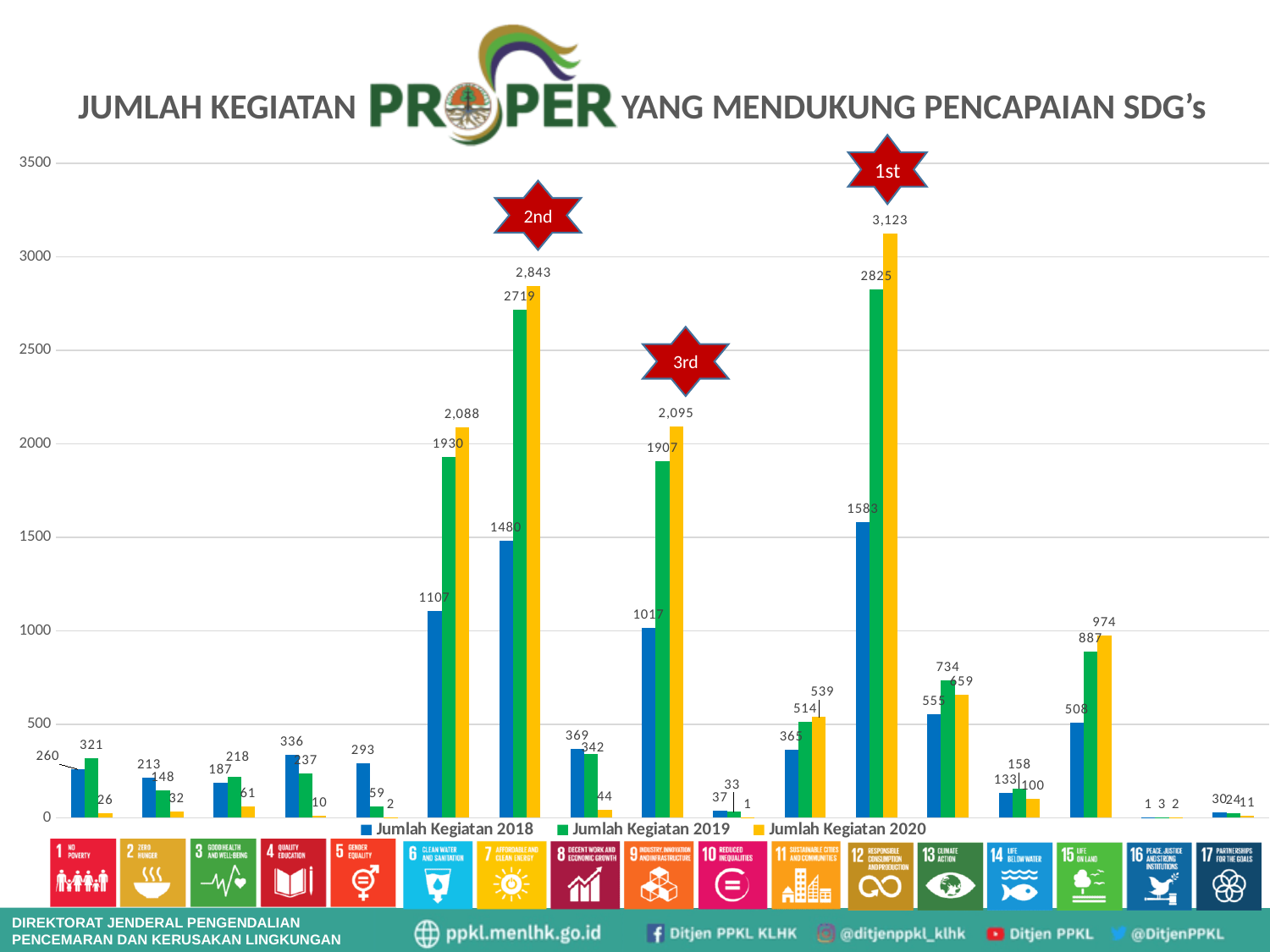
Which SDG has the lowest Jumlah Kegiatan 2018 value? SDG 16 (Peace, Justice and Strong Institutions) What kind of chart is shown on the slide? bar chart Which SDG is marked with the '1st' star on the chart? SDG 12 (Responsible Consumption and Production) Which SDG has the highest value for Jumlah Kegiatan 2020? SDG 12 (Responsible Consumption and Production) What is the Jumlah Kegiatan 2019 value for SDG 7 (Affordable and Clean Energy)? 2719 How many series does the legend list? 3 For SDG 13 (Climate Action), which is larger: the 2019 value or the 2020 value? 2019 What is the Jumlah Kegiatan 2020 value for SDG 15 (Life on Land)? 974 Is the Jumlah Kegiatan 2019 value for SDG 9 (Industry, Innovation and Infrastructure) greater or less than 1500? greater How many SDG categories are plotted along the x axis? 17 For SDG 12 (Responsible Consumption and Production), what is the difference between the 2020 value and the 2019 value? 298 What is the Jumlah Kegiatan 2018 value for SDG 12 (Responsible Consumption and Production)? 1583